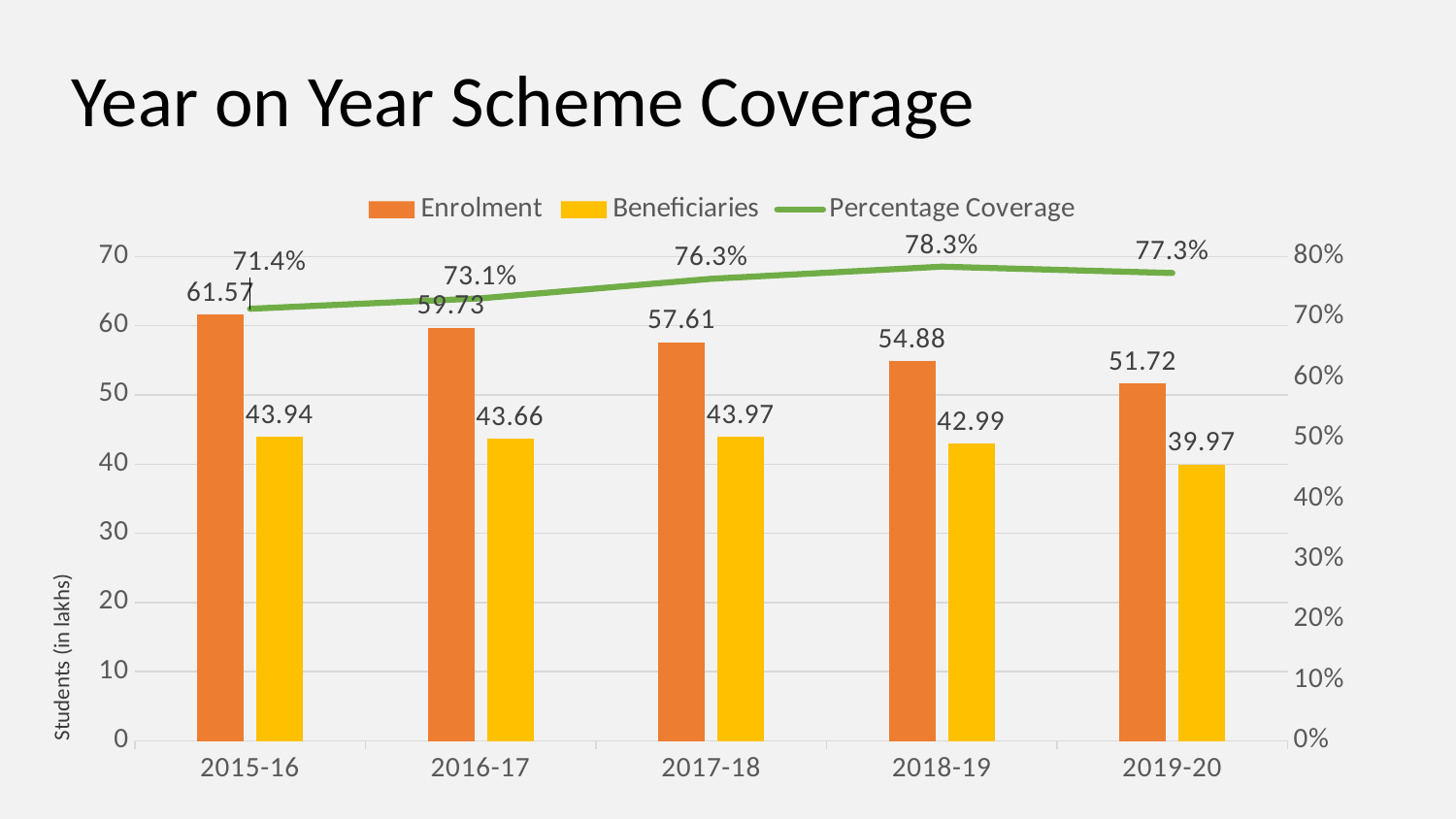
How many series does the legend list? 3 What is the Beneficiaries value for 2019-20? 39.97 What is the title of the chart? Year on Year Scheme Coverage What is the difference between Enrolment and Beneficiaries in 2015-16? 17.63 Which year has the highest Percentage Coverage? 2018-19 Does the Enrolment rise or fall from 2015-16 to 2019-20? fall Is the Enrolment for 2016-17 greater or less than the Enrolment for 2018-19? greater What is the Enrolment value for 2017-18? 57.61 What is the Percentage Coverage for 2018-19? 78.3% Which year has the lowest Beneficiaries value? 2019-20 How many years are shown on the x axis? 5 Which year has the highest Enrolment? 2015-16